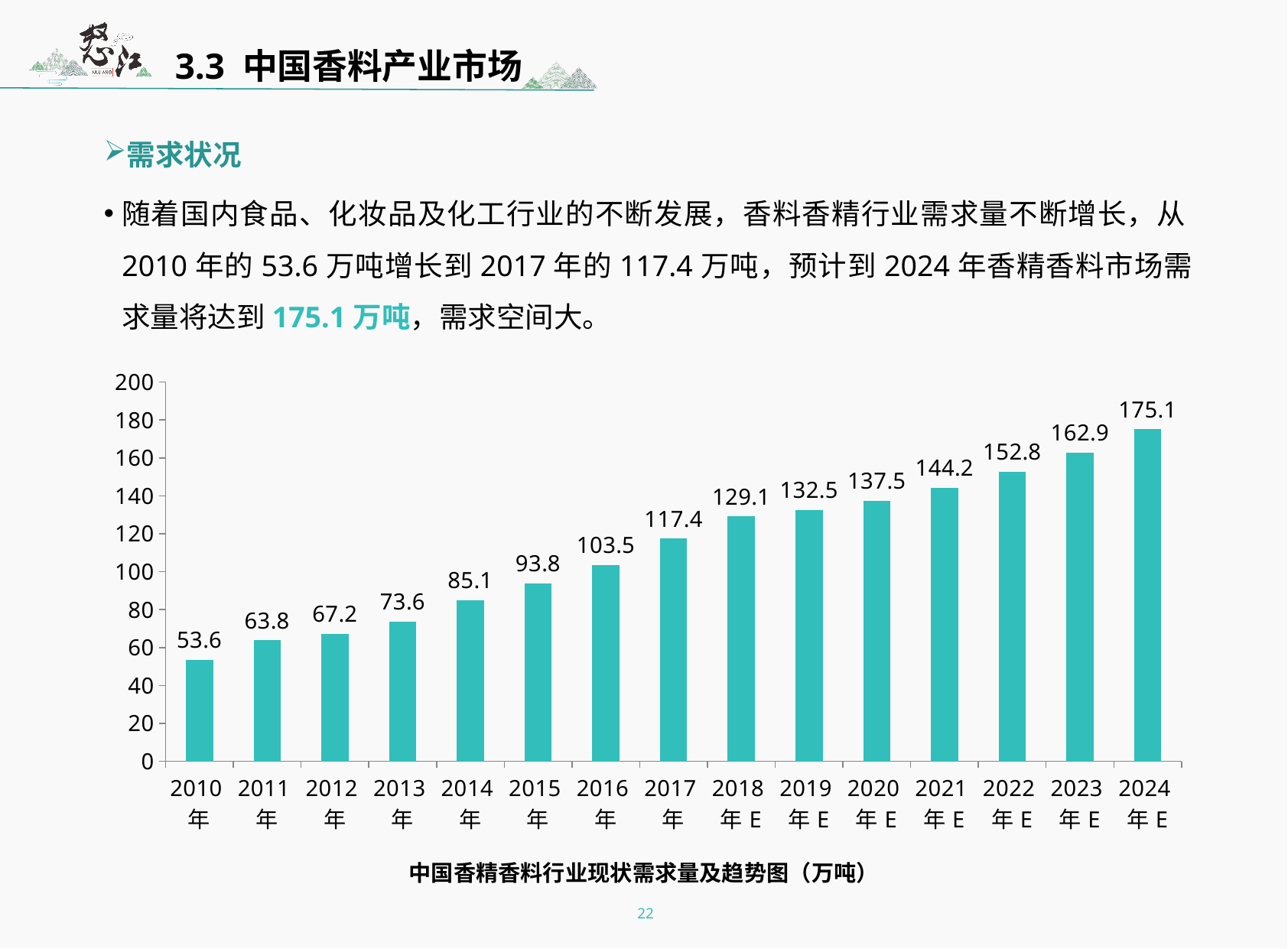
What is the value for 2017年 in the chart? 117.4 Which year has the lowest value in the chart? 2010年 What is the value for 2010年 in the chart? 53.6 What is the difference between the values for 2024年E and 2010年? 121.5 Do the values rise or fall from 2010年 to 2024年E? rise Is the value for 2018年E greater or less than 120? greater Which year has the highest value in the chart? 2024年E What kind of chart is shown on the slide? bar chart How many years are shown on the x axis of the chart? 15 What is the difference between the values for 2017年 and 2016年? 13.9 Which is larger, the value for 2015年 or the value for 2019年E? 2019年E What is the value for 2021年E in the chart? 144.2